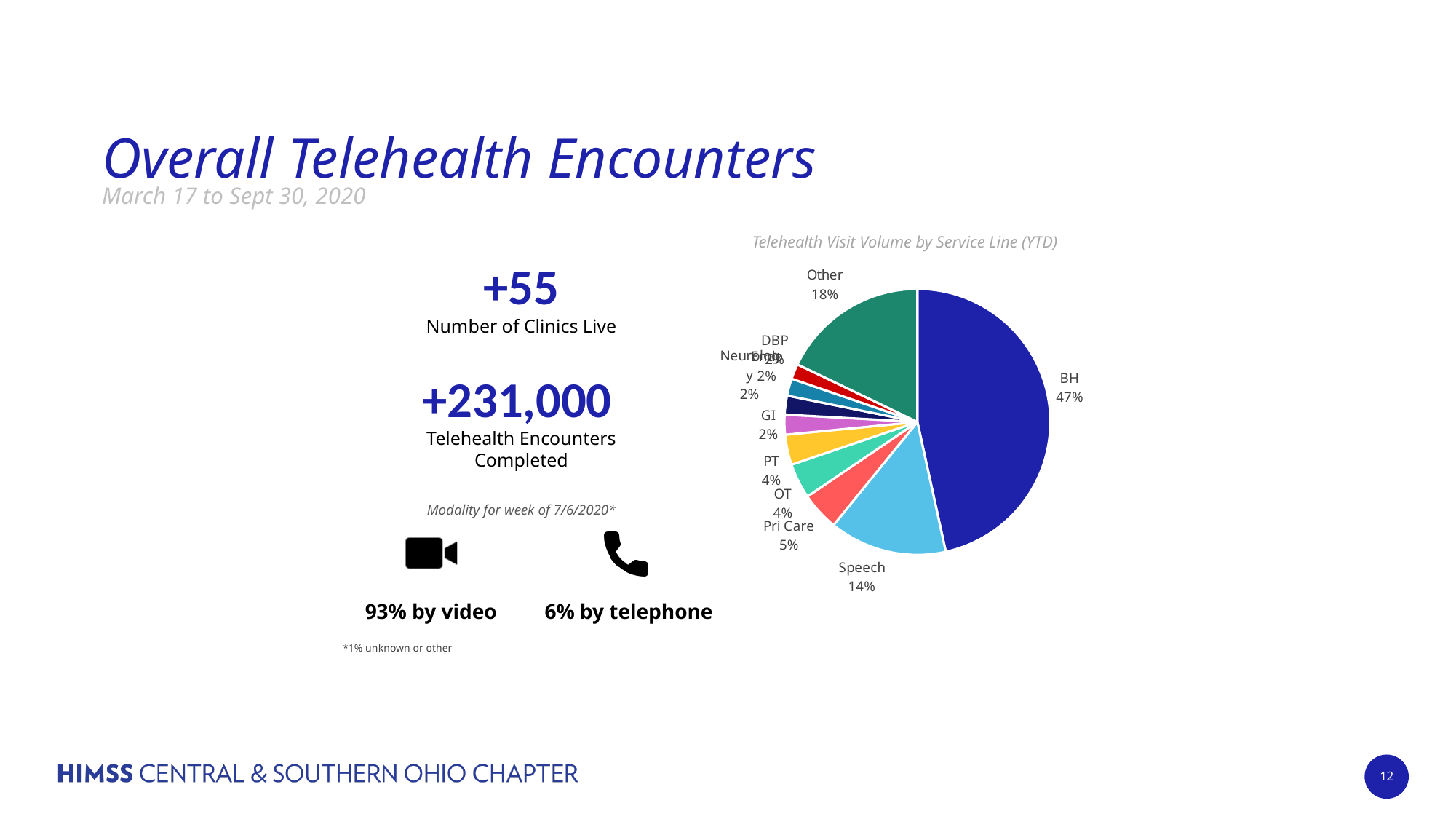
What percentage is shown for Pri Care? 5% What percentage is shown for the Other slice? 18% What is the difference in percentage points between BH and Speech? 33 percentage points How many slices does the pie chart have? 10 What percentage is shown for Speech? 14% What percentage is shown for GI? 2% Which slice is larger, Speech or Other? Other Which service line has the largest slice of the pie? BH What type of chart is shown on the slide? pie chart What percentage is shown for PT? 4% What share of telehealth visit volume does BH account for? 47% What is the title of the chart? Telehealth Visit Volume by Service Line (YTD)